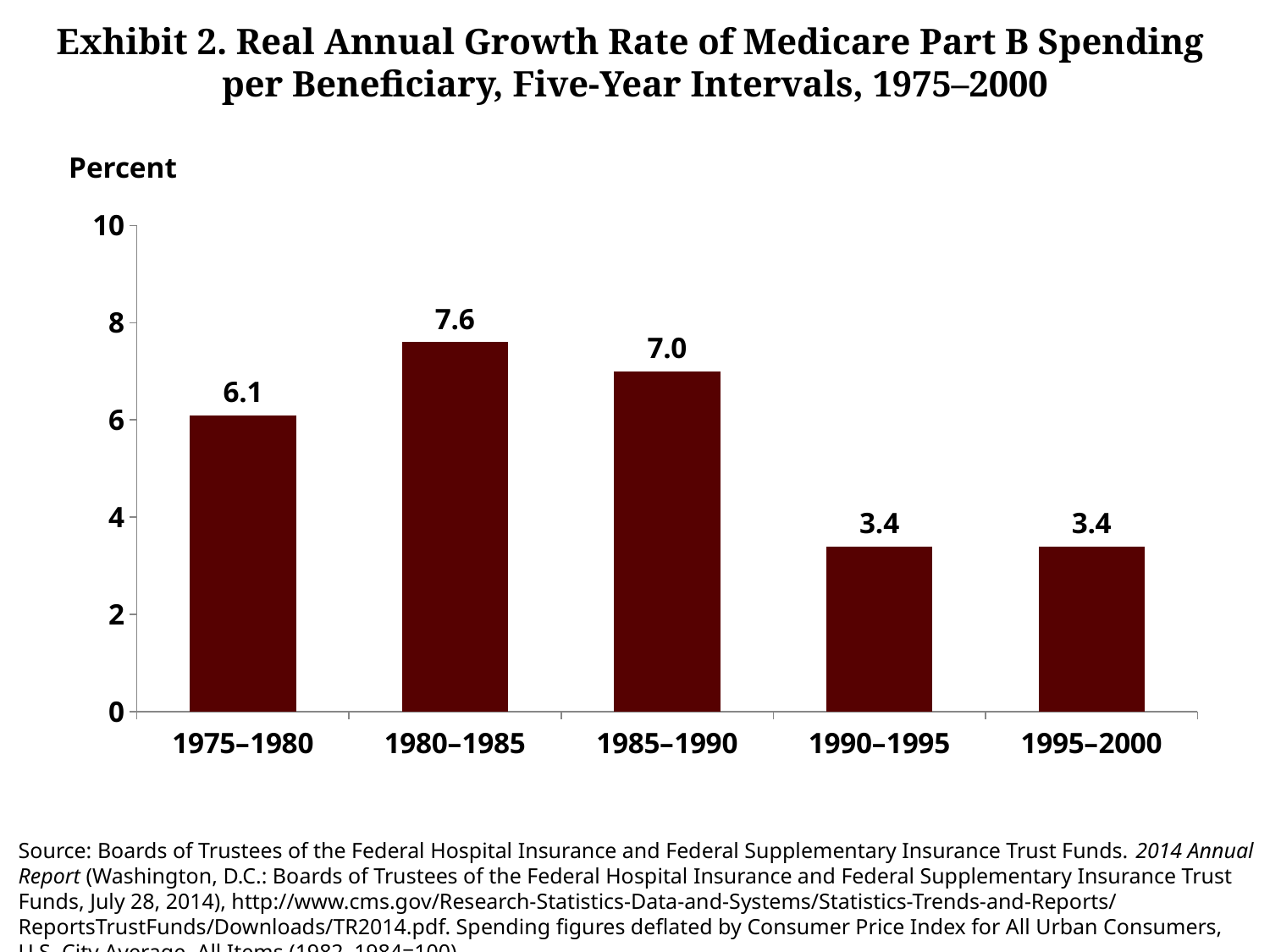
What is the difference between the growth rates for 1975–1980 and 1990–1995? 2.7 What is the value shown for 1995–2000? 3.4 What is the real annual growth rate for 1975–1980? 6.1 How many five-year intervals are shown on the chart? 5 Which is larger, the growth rate for 1975–1980 or for 1985–1990? 1985–1990 Is the value for 1985–1990 greater or less than 6? greater What is the real annual growth rate for 1980–1985? 7.6 Which five-year interval has the highest growth rate? 1980–1985 What is the difference between the growth rates for 1980–1985 and 1985–1990? 0.6 What kind of chart is shown on the slide? bar chart What unit is labelled on the vertical axis of the chart? Percent Do the growth rates rise or fall from 1980–1985 to 1995–2000? fall